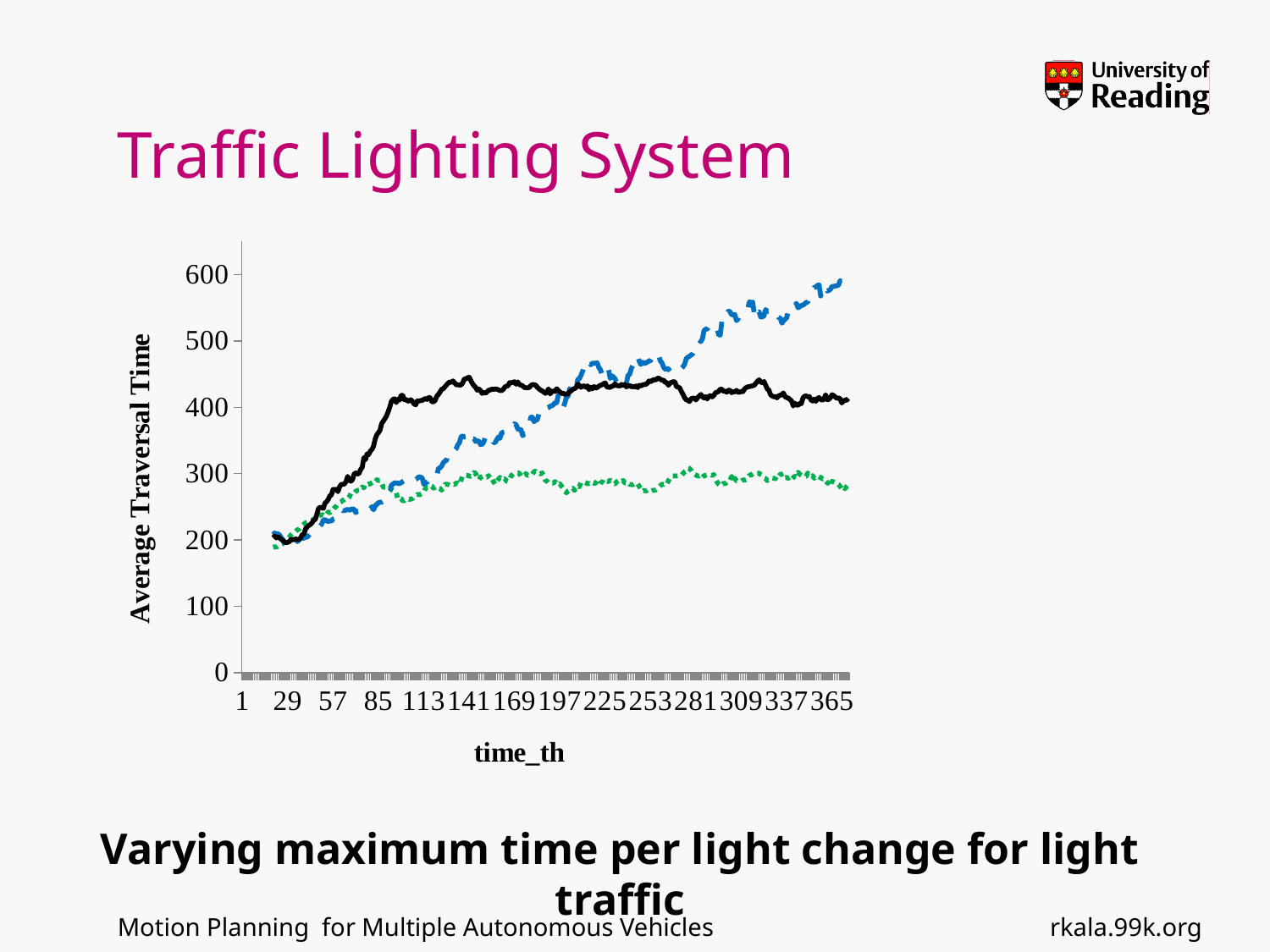
Is the value of the green dotted line at time_th 197 greater or less than 400? less At the right end of the chart, which line is higher: the blue dashed line or the green dotted line? blue dashed line Which line reaches the highest Average Traversal Time on the chart? blue dashed line Is the value of the green dotted line at the right end of the chart (time_th 365) greater or less than 300? less Is the value of the blue dashed line at the right end of the chart (time_th 365) greater or less than 500? greater What kind of chart is shown on the slide? line chart What is the title of the horizontal axis of the chart? time_th What is the title of the vertical axis of the chart? Average Traversal Time How many lines are plotted on the chart? 3 Does the blue dashed line generally rise or fall as time_th increases? rise